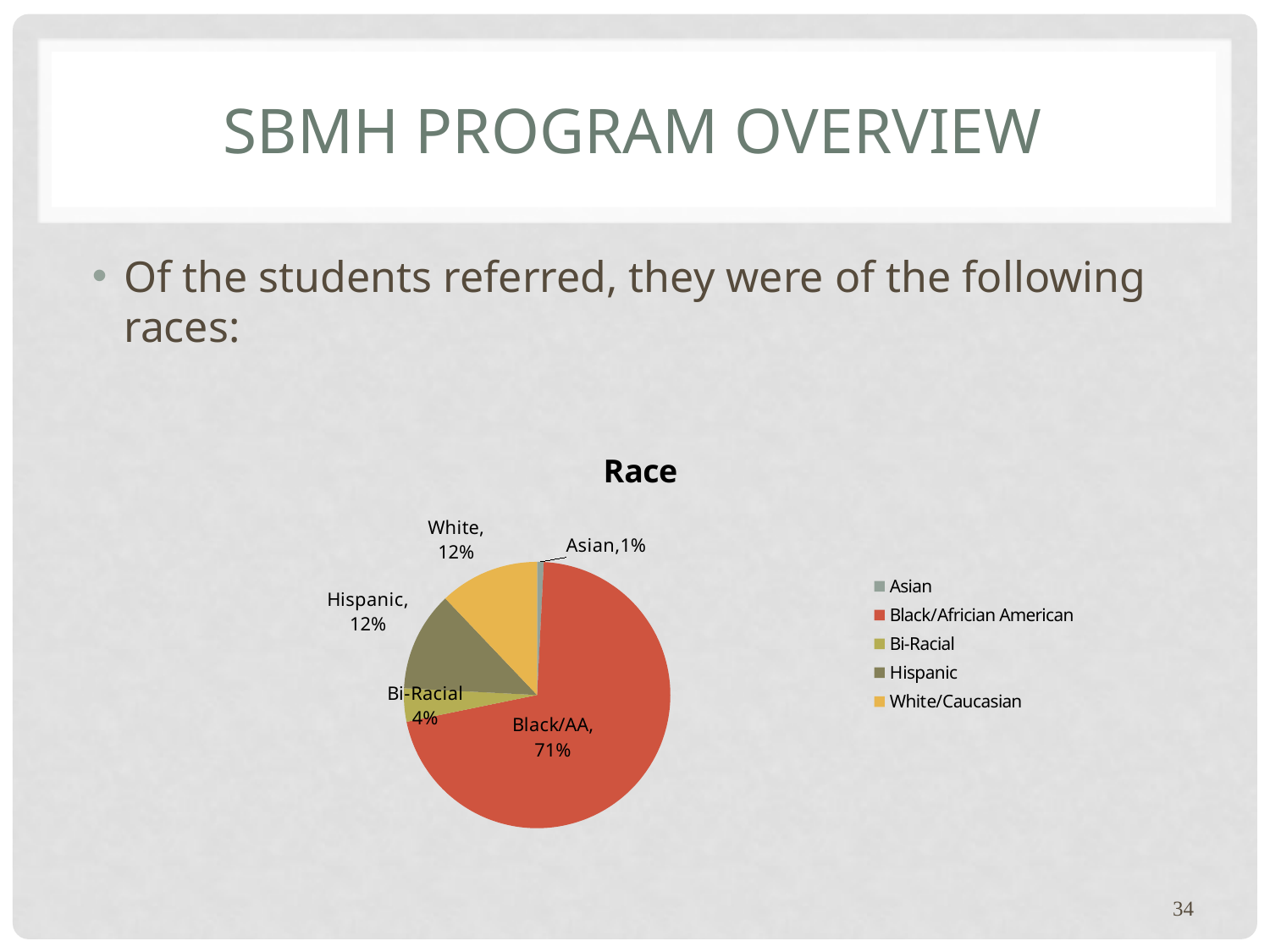
Which race has the largest share of the pie? Black/AA What is the difference in percentage points between the Black/AA slice and the White slice? 59 What percentage of referred students were Asian? 1% What type of chart is shown on the slide? pie chart What percentage of referred students were Hispanic? 12% What is the title of the chart? Race What percentage of referred students were Bi-Racial? 4% What colour is the Black/African American slice in the legend? red Which race has the smallest share of the pie? Asian Which is larger, the Hispanic slice or the Bi-Racial slice? Hispanic How many categories does the legend list? 5 What percentage of referred students were Black/AA? 71%